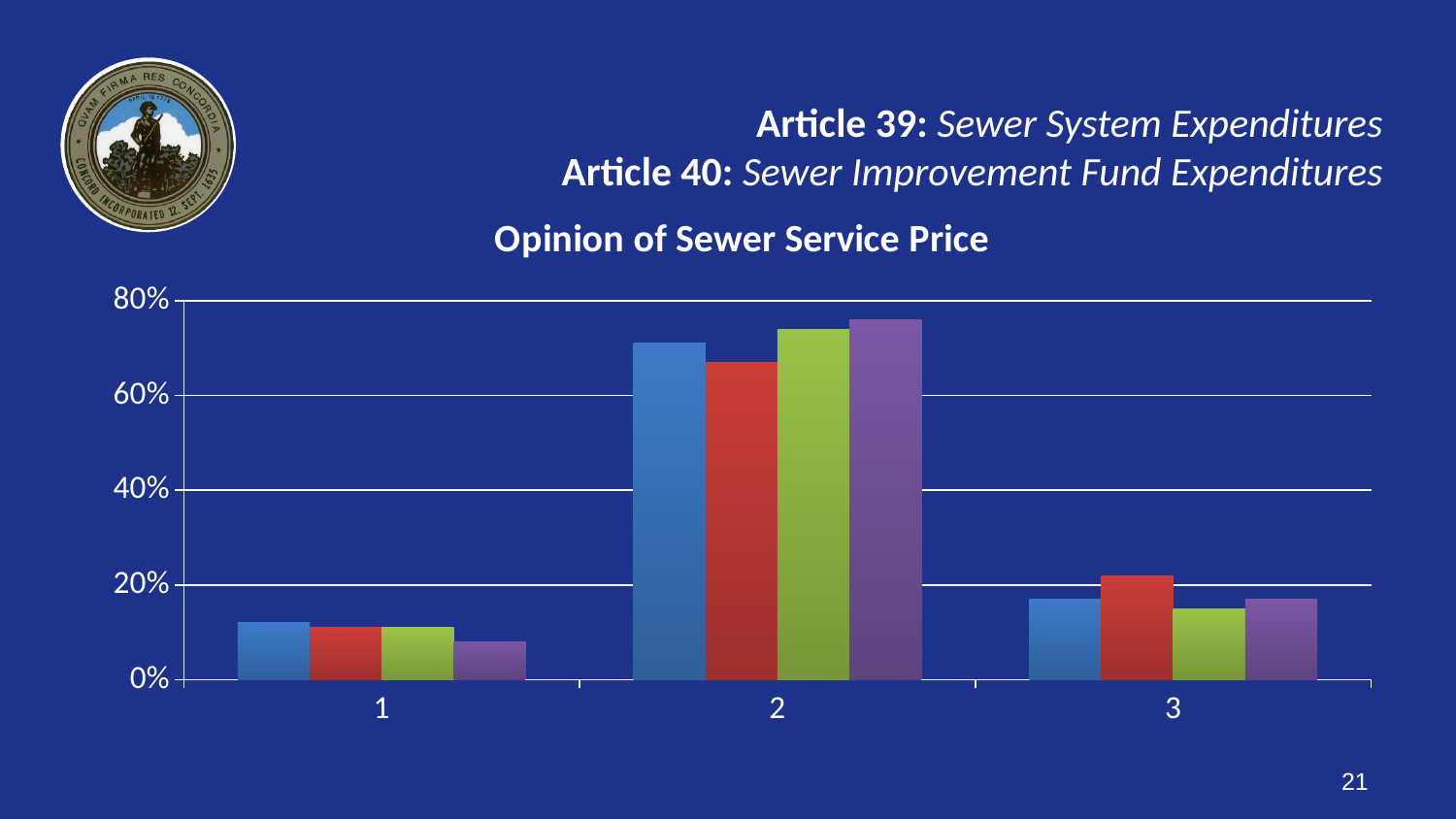
Is the value of the blue bar for category 2 greater or less than 60%? greater What is the title of the chart? Opinion of Sewer Service Price Which category has the tallest bars in the chart? 2 Is the value of the green bar for category 3 greater or less than 20%? less How many bars are plotted for each category in the chart? 4 How many categories are shown on the x axis of the chart? 3 In category 2, which bar is taller, the purple bar or the red bar? purple In category 3, which bar is taller, the red bar or the green bar? red Is the value of the purple bar for category 1 greater or less than 20%? less What kind of chart is shown on the slide? bar chart Which is larger, the blue bar for category 2 or the blue bar for category 3? category 2